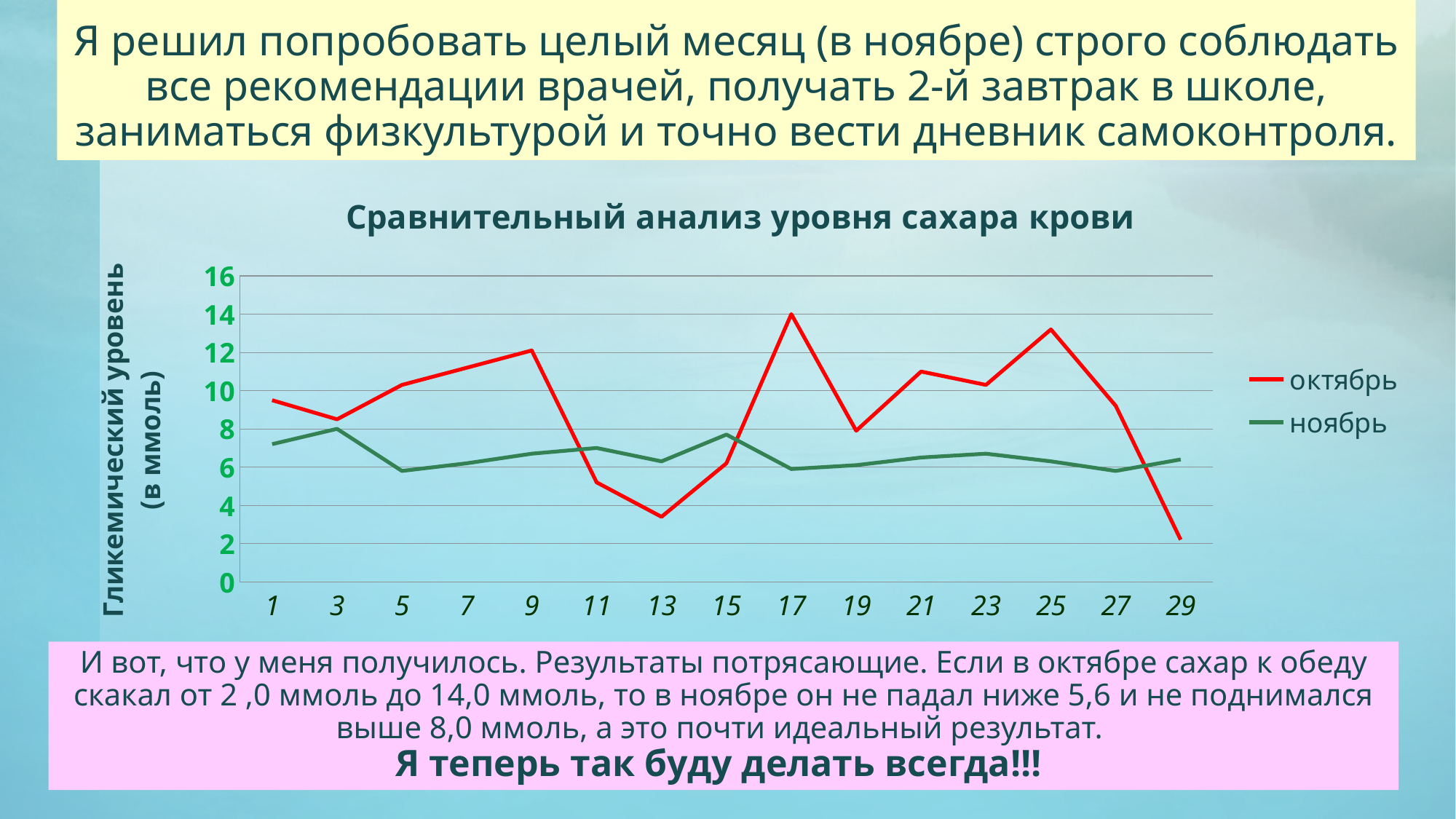
On which day does the октябрь series reach its highest value? 17 What is the title of the chart? Сравнительный анализ уровня сахара крови How many series does the legend list? 2 How many points are plotted along the x axis for each series? 15 Is the value for октябрь on day 25 greater or less than 12? greater Is the value for ноябрь on day 15 greater or less than 6? greater Is the value for октябрь on day 29 greater or less than 4? less On day 13, which series has the larger value, октябрь or ноябрь? ноябрь On which day does the октябрь series reach its lowest value? 29 On day 9, which series has the larger value, октябрь or ноябрь? октябрь What kind of chart is shown on the slide? line chart